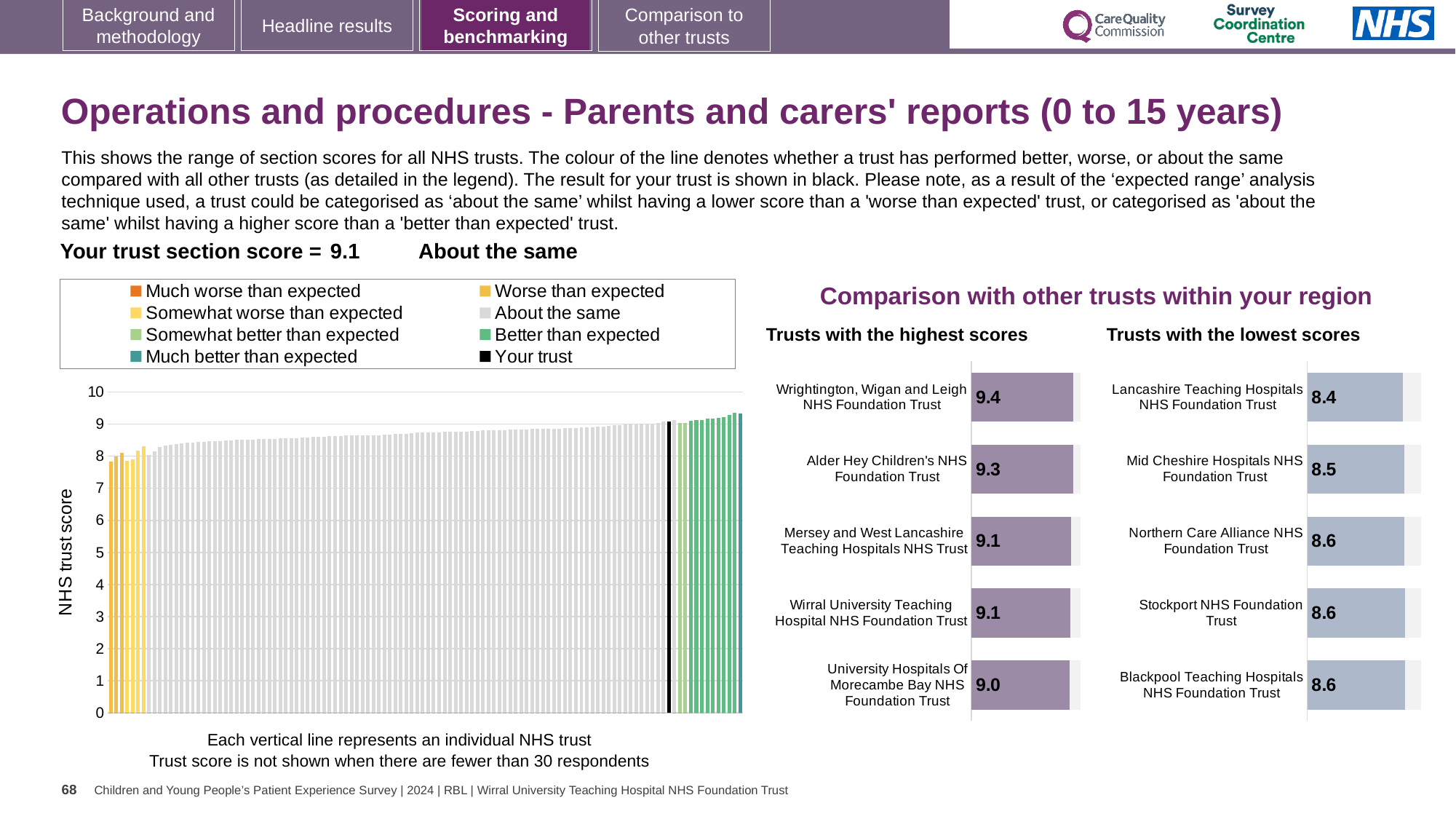
What kind of chart is the main chart on the left showing NHS trust scores? Bar chart In the 'Trusts with the lowest scores' chart, what is the score for Lancashire Teaching Hospitals NHS Foundation Trust? 8.4 How many trusts are shown in the 'Trusts with the highest scores' chart? 5 In the 'Trusts with the lowest scores' chart, what is the score for Mid Cheshire Hospitals NHS Foundation Trust? 8.5 Which has the higher score: Alder Hey Children's NHS Foundation Trust or Mid Cheshire Hospitals NHS Foundation Trust? Alder Hey Children's NHS Foundation Trust How many entries does the legend of the main chart on the left list? 8 In the main chart on the left, is the value for your trust greater or less than 8? greater In the 'Trusts with the lowest scores' chart, which trust has the lowest score? Lancashire Teaching Hospitals NHS Foundation Trust In the 'Trusts with the highest scores' chart, what is the score for Alder Hey Children's NHS Foundation Trust? 9.3 In the 'Trusts with the highest scores' chart, what is the score for Wrightington, Wigan and Leigh NHS Foundation Trust? 9.4 In the 'Trusts with the highest scores' chart, which trust has the highest score? Wrightington, Wigan and Leigh NHS Foundation Trust What is the difference between the scores of Wrightington, Wigan and Leigh NHS Foundation Trust and University Hospitals Of Morecambe Bay NHS Foundation Trust in the 'Trusts with the highest scores' chart? 0.4